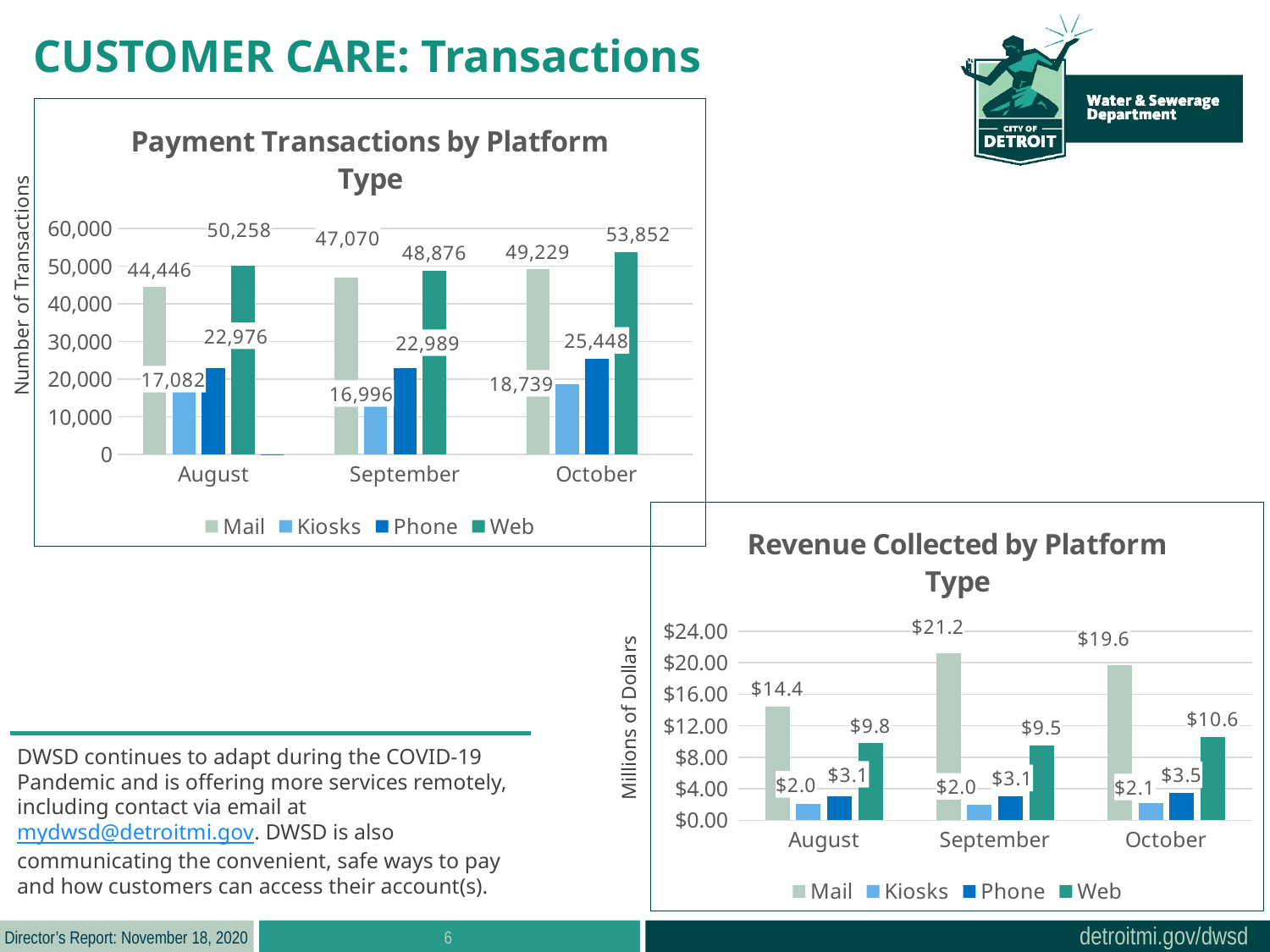
In the 'Payment Transactions by Platform Type' chart, what is the difference between Web and Mail transactions in August? 5,812 In the 'Payment Transactions by Platform Type' chart, which platform had the lowest number of transactions in August? Kiosks In the 'Payment Transactions by Platform Type' chart, which was larger in September: Mail or Web transactions? Web In the 'Revenue Collected by Platform Type' chart, how much revenue was collected by Mail in September? $21.2 How many series does the legend of the 'Payment Transactions by Platform Type' chart list? 4 In the 'Payment Transactions by Platform Type' chart, how many Web transactions were there in October? 53,852 In the 'Revenue Collected by Platform Type' chart, what is the difference between Mail revenue in September and August? $6.8 In the 'Payment Transactions by Platform Type' chart, which month had the highest number of Mail transactions? October In the 'Revenue Collected by Platform Type' chart, how much revenue was collected by Phone in October? $3.5 What type of chart is the 'Revenue Collected by Platform Type' chart? Bar chart In the 'Payment Transactions by Platform Type' chart, how many Kiosks transactions were there in September? 16,996 In the 'Revenue Collected by Platform Type' chart, which month had the highest Web revenue? October